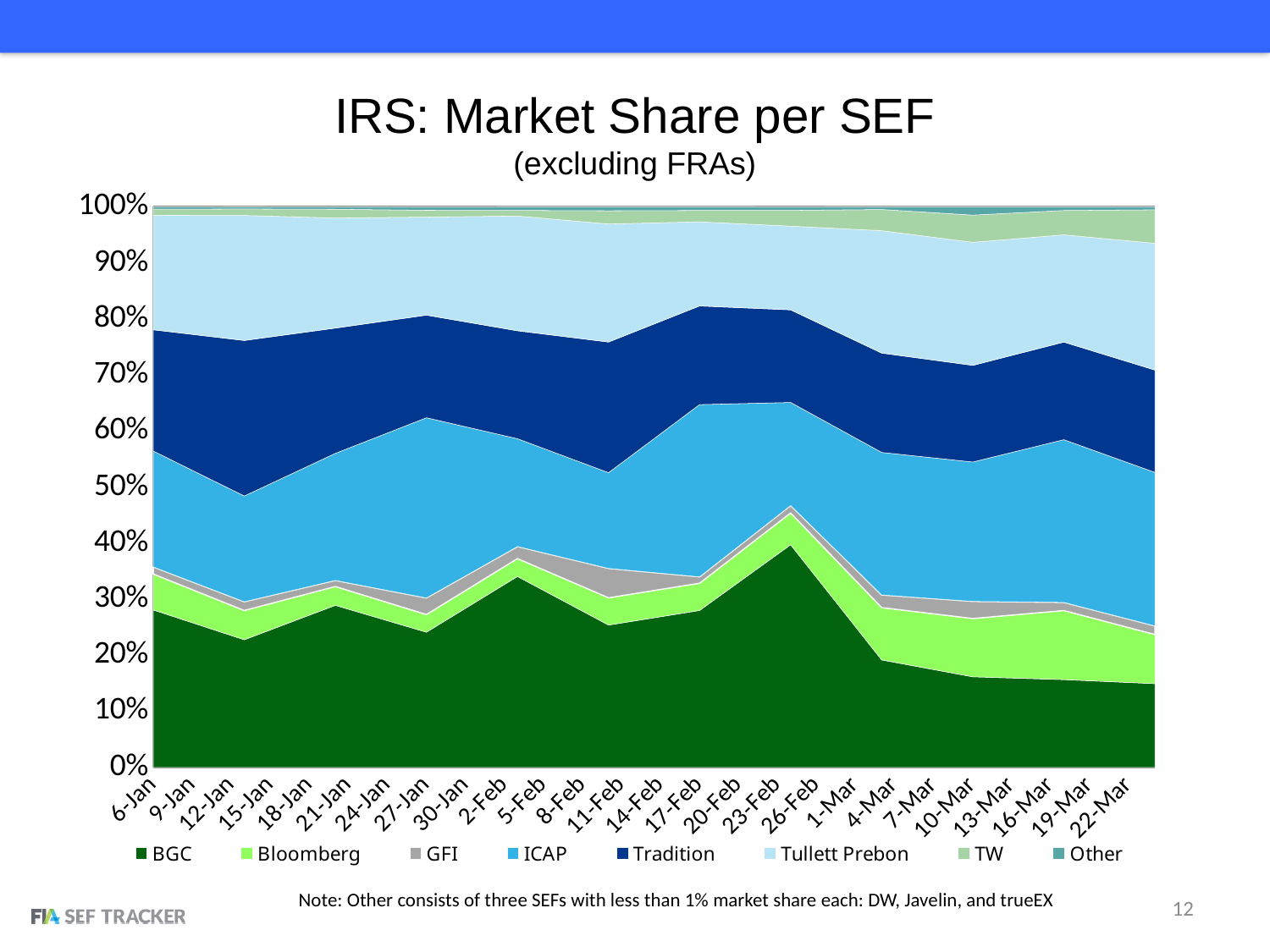
Does the BGC market share rise or fall from 26-Feb to 22-Mar? fall Which is larger, the BGC market share on 26-Feb or on 4-Mar? 26-Feb Is the value for BGC on 6-Jan greater or less than 20%? greater Which series is listed first in the legend? BGC What is the last date shown on the x axis? 22-Mar What is the title of the chart? IRS: Market Share per SEF (excluding FRAs) Is the value for BGC on 22-Mar greater or less than 20%? less What is the first date shown on the x axis? 6-Jan How many series does the legend list? 8 What kind of chart is shown on the slide? Stacked area chart Is the value for BGC on 26-Feb greater or less than 30%? greater